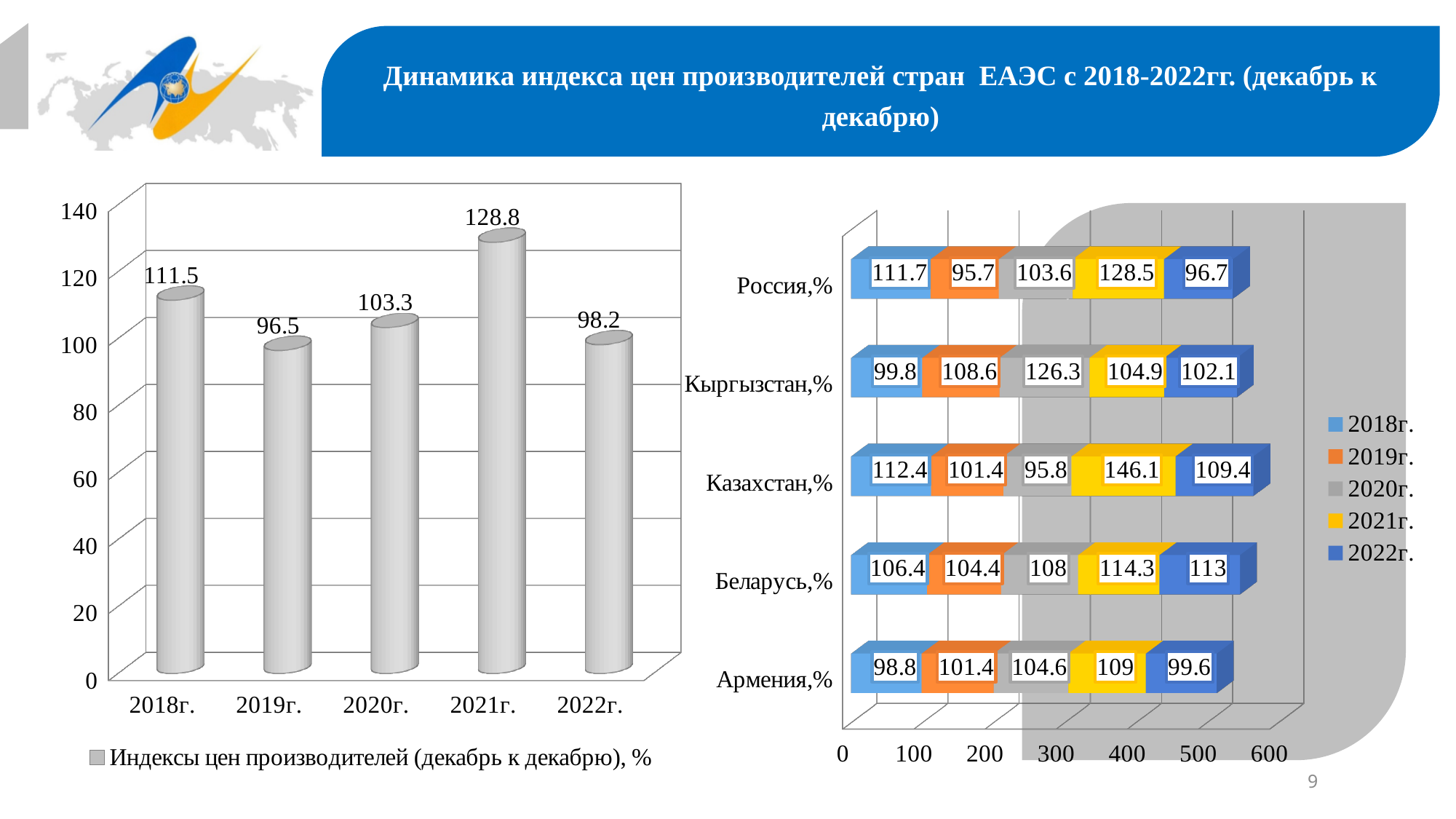
In the right chart, which colour represents 2021г. in the legend? Yellow In the right chart, how many series does the legend list? 5 In the right chart, which is larger for Россия,%: the 2018г. value or the 2019г. value? 2018г. In the left chart, how many bars are plotted? 5 In the right chart, what is the 2021г. value for Казахстан,%? 146.1 What kind of chart is the left chart? Bar chart In the left chart, what is the value for 2021г.? 128.8 In the left chart, which year has the lowest value? 2019г. In the right chart, what is the 2020г. value for Кыргызстан,%? 126.3 In the right chart, what is the total of the stacked bar for Армения,%? 513.4 In the left chart, what is the difference between the values for 2021г. and 2019г.? 32.3 In the left chart, is the value for 2020г. greater or less than 100? greater